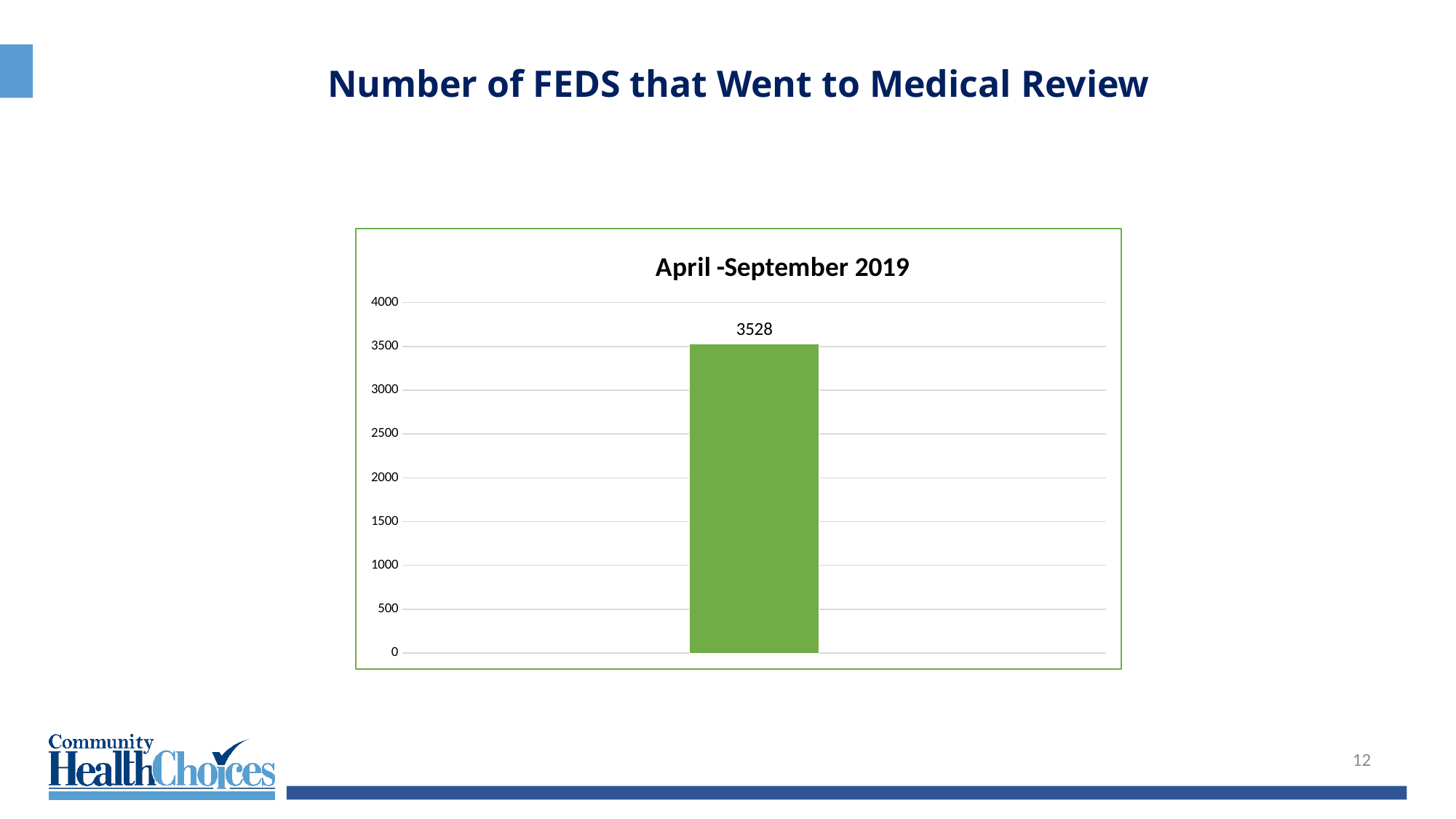
Is the value of the bar greater or less than 4000? less What colour is the bar in the chart? green What kind of chart is shown on the slide? bar chart What is the highest value shown on the vertical axis of the chart? 4000 What value is shown for the bar in the chart? 3528 What is the title of the chart? April -September 2019 Is the value of the bar greater or less than 3000? greater How many bars are plotted in the chart? 1